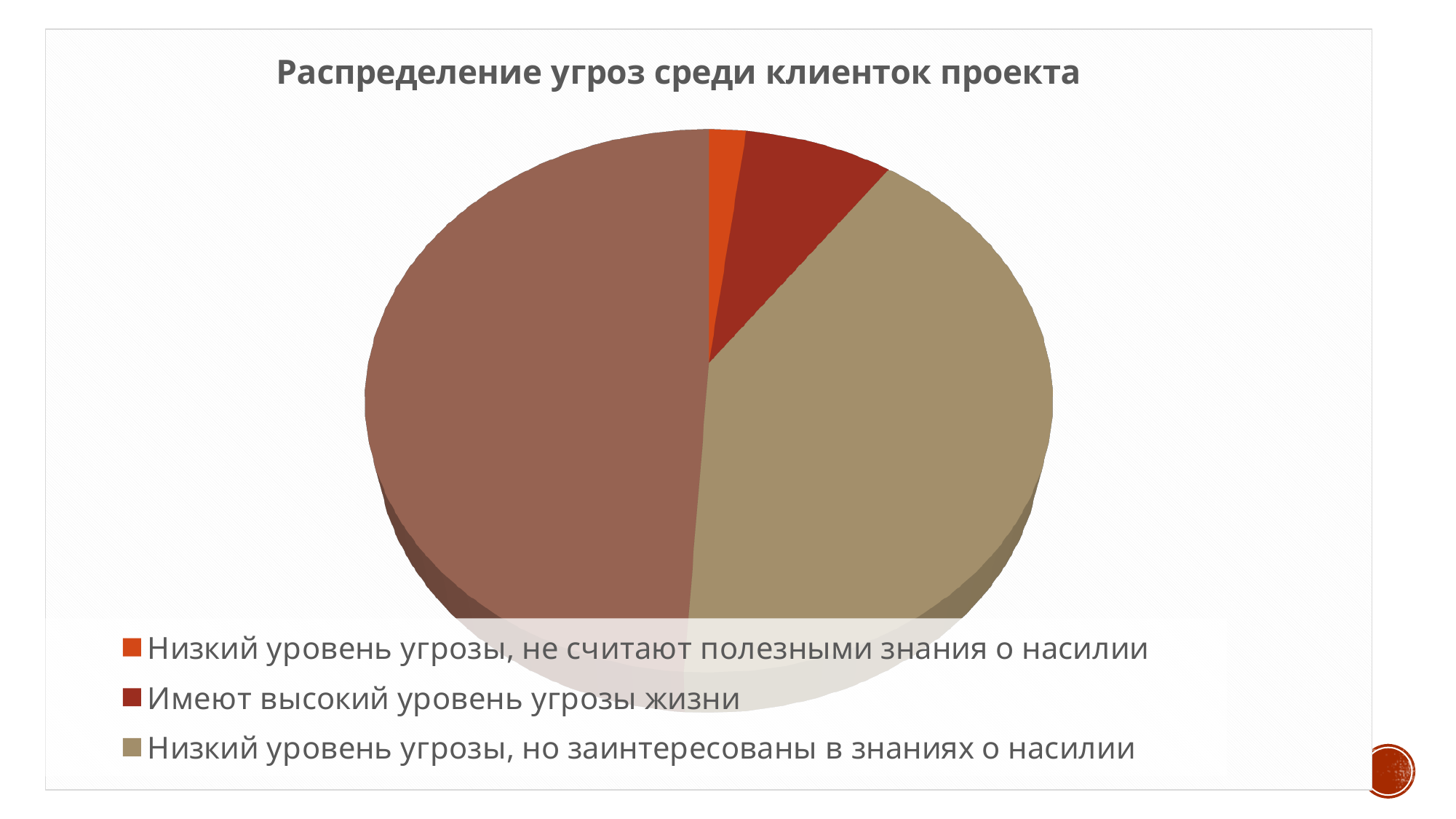
What colour is the slice for "Имеют высокий уровень угрозы жизни"? Dark red How many entries does the chart's legend list? 3 Which legend category has the smallest slice of the pie? Низкий уровень угрозы, не считают полезными знания о насилии Which slice is larger: "Низкий уровень угрозы, но заинтересованы в знаниях о насилии" or "Имеют высокий уровень угрозы жизни"? Низкий уровень угрозы, но заинтересованы в знаниях о насилии What is the title of the chart? Распределение угроз среди клиенток проекта What kind of chart is shown on the slide? Pie chart Which slice is larger: "Имеют высокий уровень угрозы жизни" or "Низкий уровень угрозы, не считают полезными знания о насилии"? Имеют высокий уровень угрозы жизни Which of the three legend categories has the largest slice of the pie? Низкий уровень угрозы, но заинтересованы в знаниях о насилии